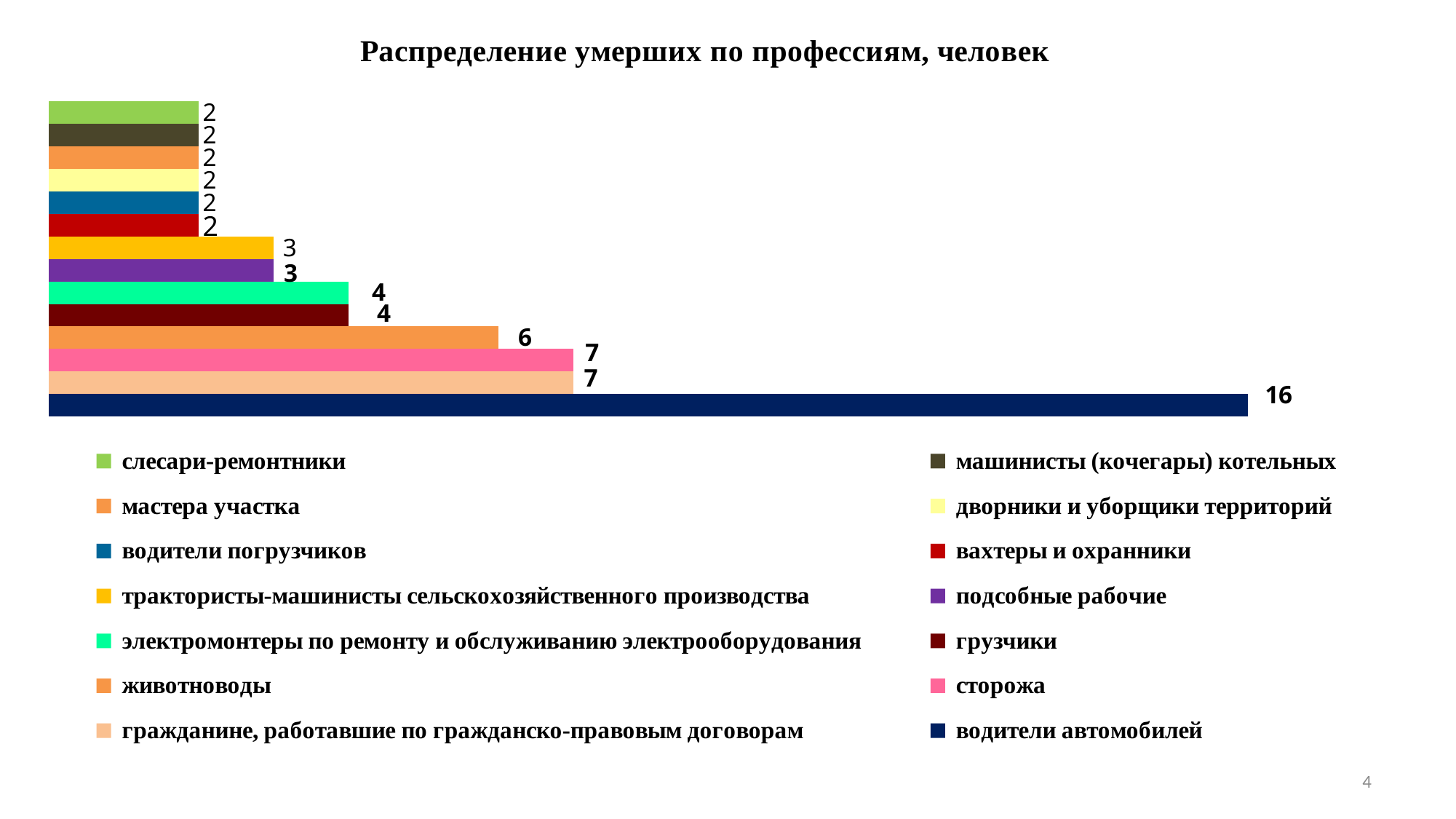
Which profession has the highest value? водители автомобилей How many entries does the legend list? 14 What is the value for водители автомобилей? 16 What is the title of the chart? Распределение умерших по профессиям, человек What is the difference between the values for водители автомобилей and сторожа? 9 What is the value for грузчики? 4 What is the value for животноводы? 6 Which is larger, the value for животноводы or the value for электромонтеры по ремонту и обслуживанию электрооборудования? животноводы How many bars are plotted in the chart? 14 What kind of chart is shown on the slide? bar chart What is the value for сторожа? 7 What is the value for подсобные рабочие? 3